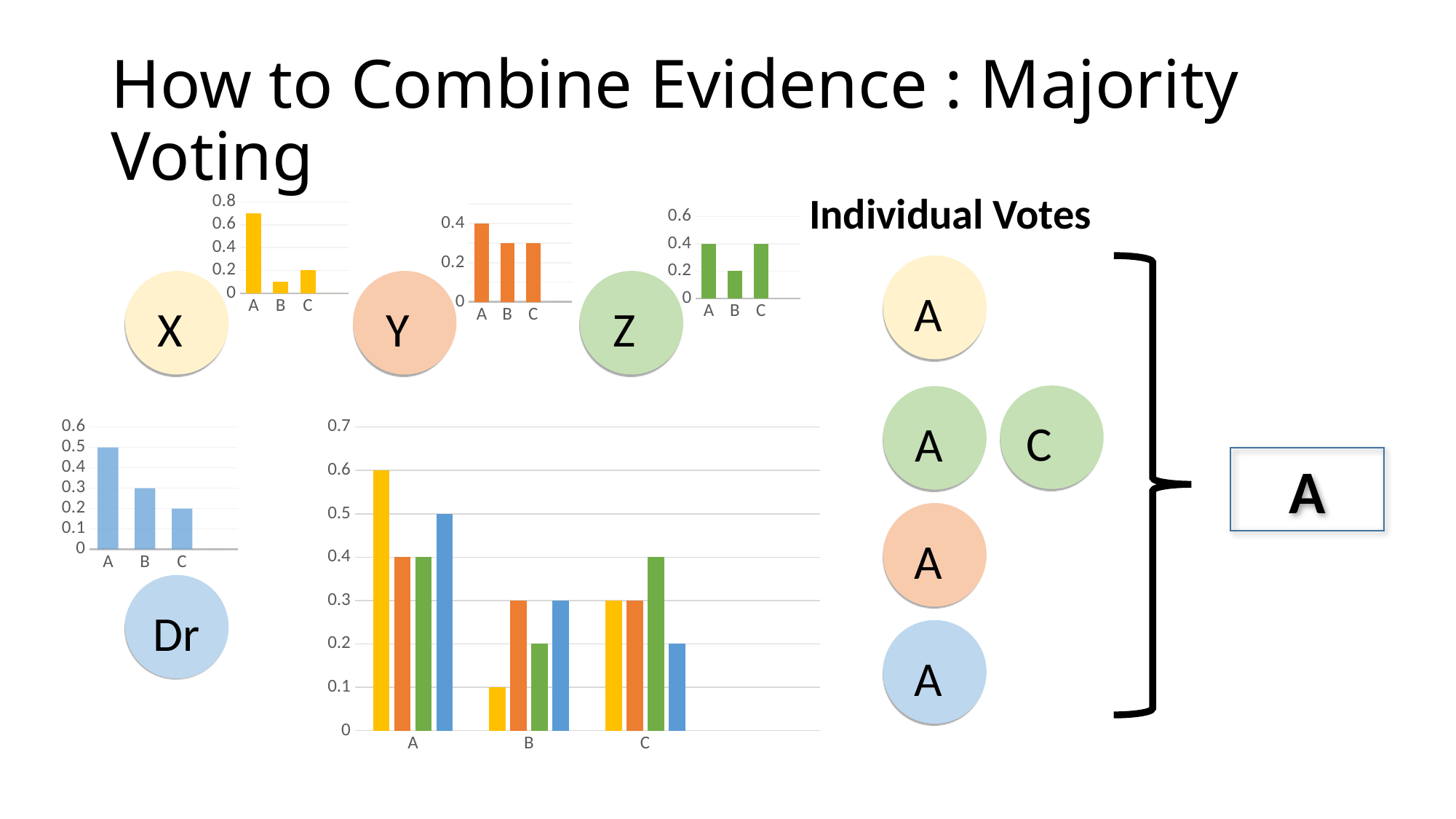
How many categories are shown on the x axis of the large chart at the bottom centre? 3 In the Z chart (top row, green bars), what is the value for B? 0.2 In the Y chart (top row, orange bars), what is the value for A? 0.4 In the Z chart (top row, green bars), which category has the lowest value? B In the Dr chart (bottom left), which category has the highest value? A In the X chart (top row, yellow bars), which category has the highest value? A In the X chart (top row, yellow bars), is the value for A greater or less than 0.6? greater In the large chart at the bottom centre, what is the value of the yellow bar for category A? 0.6 In the large chart at the bottom centre, which is larger for category C: the green bar or the blue bar? the green bar What kind of chart is the large chart at the bottom centre? bar chart In the Dr chart (bottom left), what is the difference between the values for A and B? 0.2 In the Dr chart (bottom left), what is the value for A? 0.5